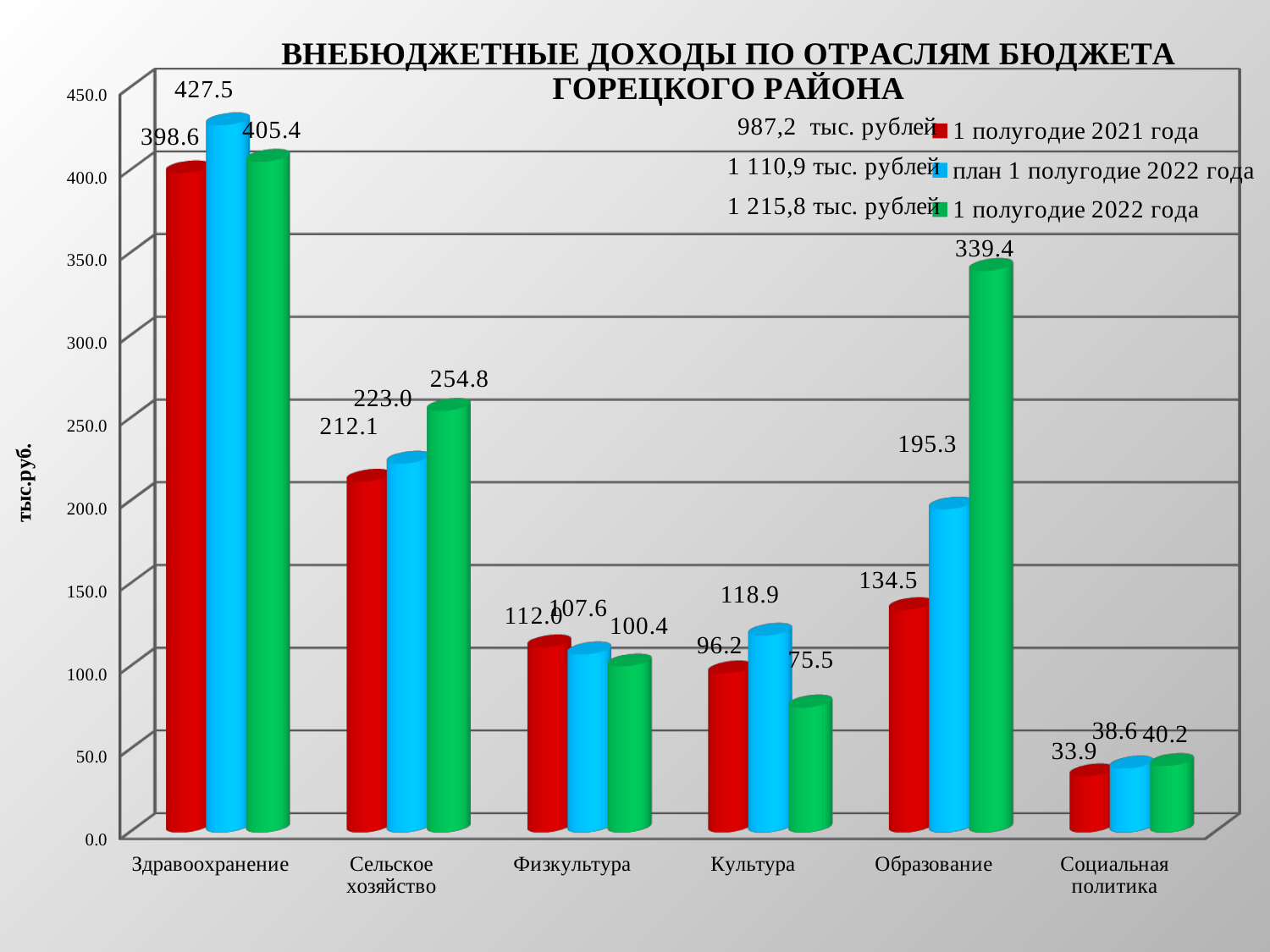
What is the difference between the '1 полугодие 2022 года' and '1 полугодие 2021 года' values for Образование? 204.9 How many categories are shown on the x axis? 6 How many series does the legend list? 3 What is the label of the vertical axis? тыс.руб. Which category has the lowest value in the series '1 полугодие 2022 года'? Социальная политика What is the value for Культура in the series '1 полугодие 2021 года'? 96.2 For Физкультура, which series has the larger value: '1 полугодие 2021 года' or '1 полугодие 2022 года'? 1 полугодие 2021 года What is the value for Здравоохранение in the series 'план 1 полугодие 2022 года'? 427.5 What is the value for Образование in the series '1 полугодие 2022 года'? 339.4 What type of chart is shown on the slide? bar chart Which category has the highest value in the series '1 полугодие 2021 года'? Здравоохранение Is the value for Сельское хозяйство in the series '1 полугодие 2022 года' greater or less than 250.0? greater